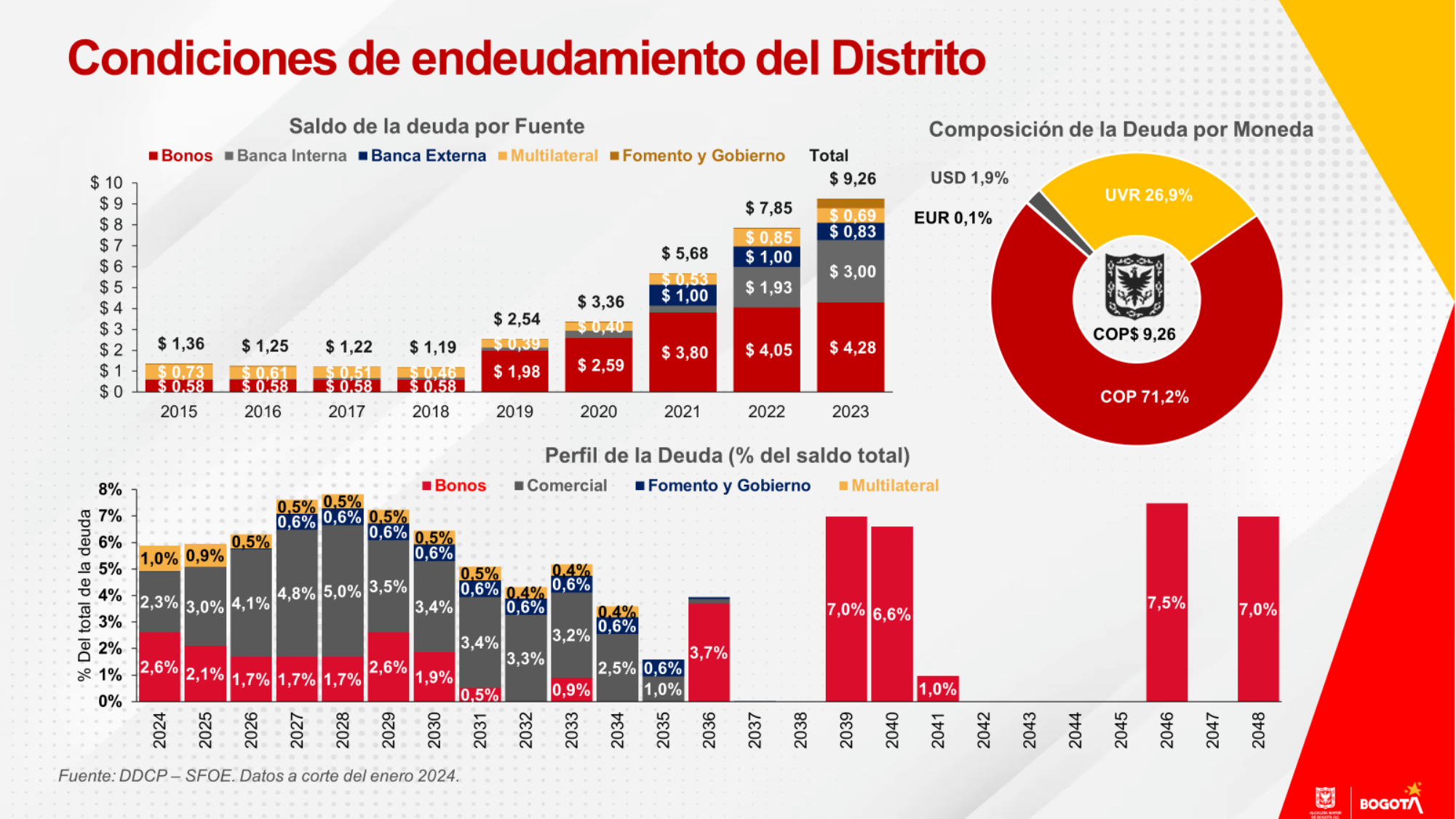
In the 'Saldo de la deuda por Fuente' chart, what is the Banca Interna value for 2022? $ 1,93 In the 'Composición de la Deuda por Moneda' chart, which currency has the smallest share? EUR In the 'Perfil de la Deuda' chart, which year has the highest Bonos value? 2046 What kind of chart is 'Composición de la Deuda por Moneda'? Donut (pie) chart In the 'Saldo de la deuda por Fuente' chart, what is the Bonos value for 2021? $ 3,80 In the 'Saldo de la deuda por Fuente' chart, how many series does the legend list? 5 In the 'Perfil de la Deuda' chart, what is the Comercial value for 2028? 5,0% In the 'Perfil de la Deuda' chart, is the Bonos value for 2039 larger or smaller than the Bonos value for 2040? larger In the 'Composición de la Deuda por Moneda' chart, what share of the debt is in UVR? 26,9% In the 'Saldo de la deuda por Fuente' chart, what is the total debt balance shown for 2023? $ 9,26 In the 'Saldo de la deuda por Fuente' chart, what is the difference between the total for 2023 and the total for 2022? $ 1,41 In the 'Saldo de la deuda por Fuente' chart, which year has the lowest total debt balance? 2018